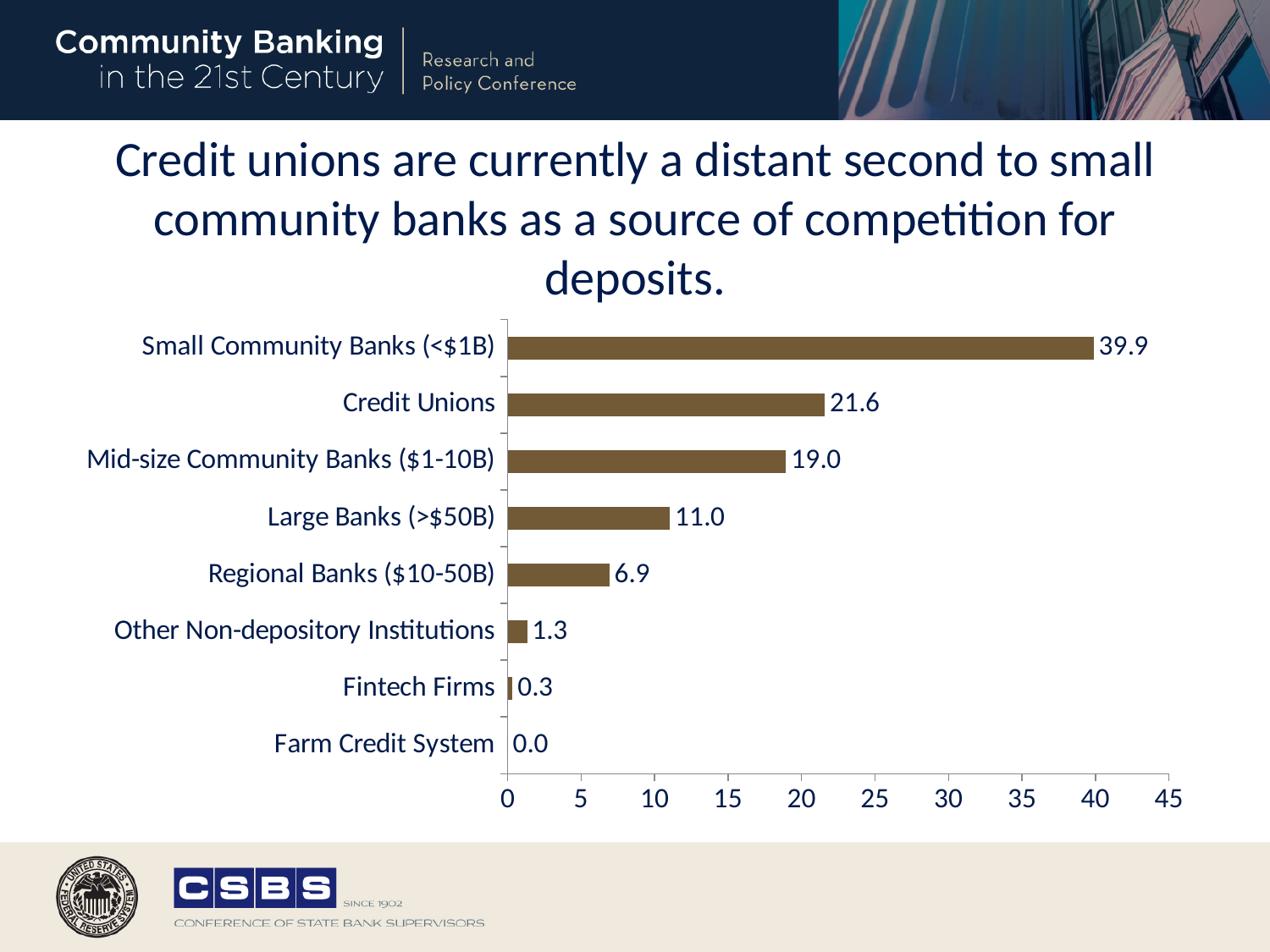
What kind of chart is shown on the slide? bar chart What is the difference between the values for Small Community Banks (<$1B) and Credit Unions? 18.3 How many categories are shown in the chart? 8 Which is larger, the value for Credit Unions or the value for Mid-size Community Banks ($1-10B)? Credit Unions Is the value for Large Banks (>$50B) greater or less than 15? less What is the value for Credit Unions? 21.6 What is the value for Fintech Firms? 0.3 What is the value for Small Community Banks (<$1B)? 39.9 Which category has the lowest value? Farm Credit System What is the value for Regional Banks ($10-50B)? 6.9 Which category has the highest value? Small Community Banks (<$1B) What is the difference between the values for Mid-size Community Banks ($1-10B) and Large Banks (>$50B)? 8.0